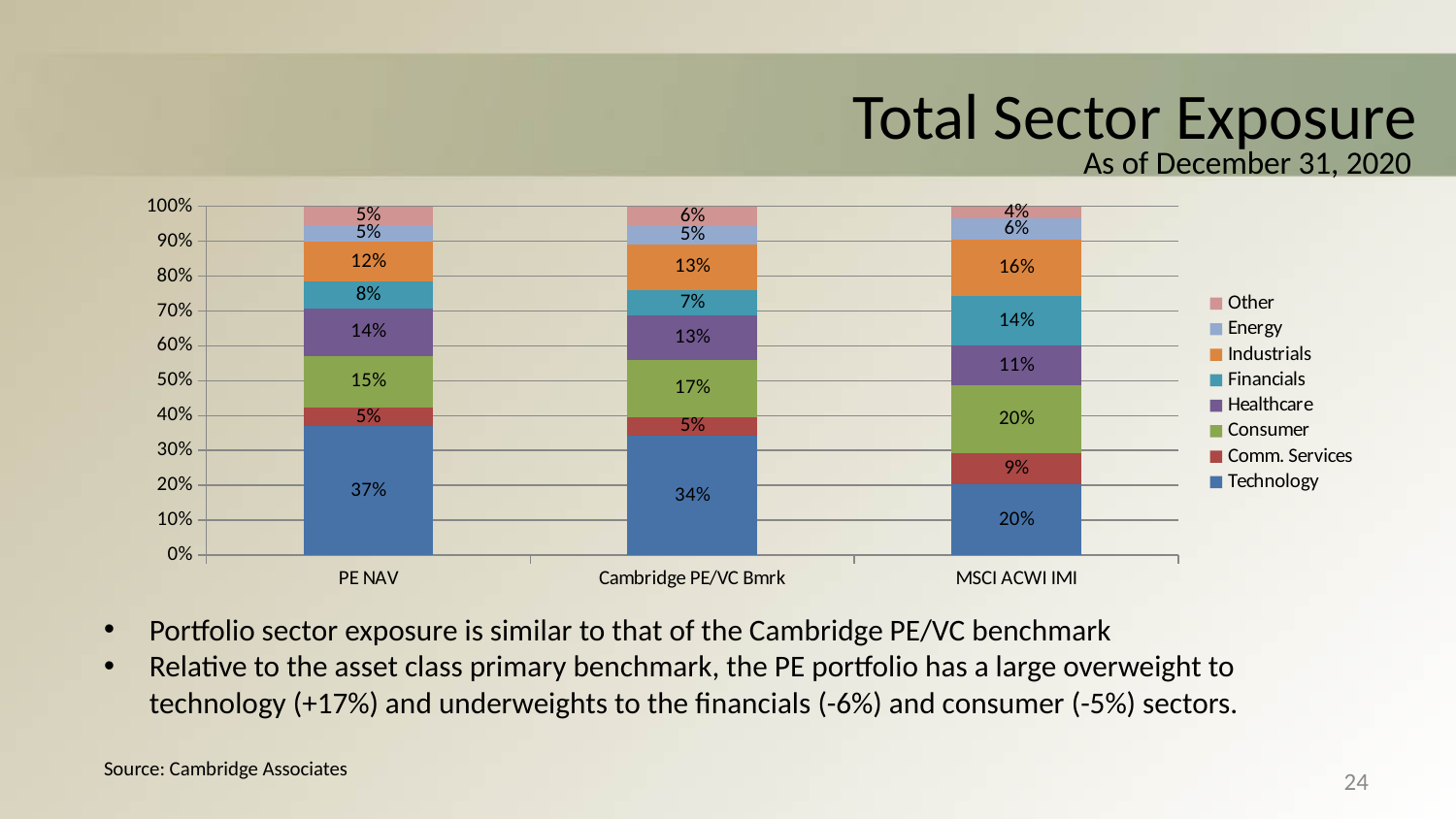
Which is larger: the Healthcare share for PE NAV or for MSCI ACWI IMI? PE NAV What is the Financials share for MSCI ACWI IMI? 14% What is the title of the chart? Total Sector Exposure What is the Technology share for PE NAV? 37% How many bars (categories) are shown on the x axis? 3 How many series does the legend list? 8 Which bar has the highest Technology share? PE NAV What is the Industrials share for PE NAV? 12% What is the difference between the Technology share for PE NAV and for MSCI ACWI IMI? 17% What is the Consumer share for Cambridge PE/VC Bmrk? 17% Which bar has the lowest Comm. Services share? PE NAV and Cambridge PE/VC Bmrk (both 5%) What type of chart is shown on the slide? Stacked bar chart